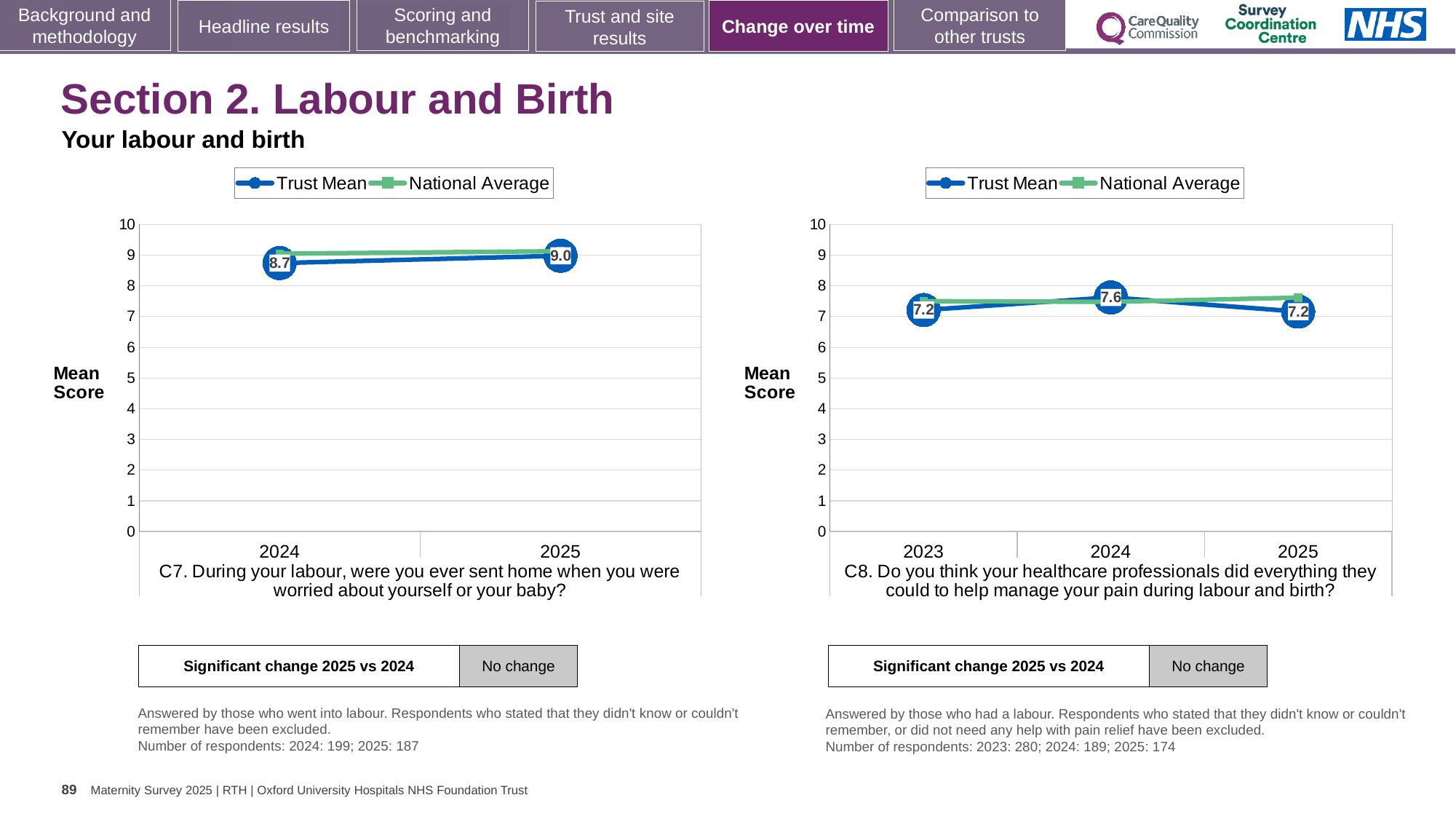
How many series does the legend of the left chart (C7) list? 2 In the right chart (C8), what is the difference between the Trust Mean in 2024 and in 2025? 0.4 In the left chart (C7), what is the Trust Mean score for 2024? 8.7 In the right chart (C8), which year has the highest Trust Mean score? 2024 In the left chart (C7), does the Trust Mean rise or fall from 2024 to 2025? rise In the left chart (C7), what is the Trust Mean score for 2025? 9.0 In the right chart (C8), what is the Trust Mean score for 2024? 7.6 What kind of chart is the right chart (C8)? line chart In the left chart (C7), by how much did the Trust Mean change from 2024 to 2025? 0.3 How many years are plotted on the x axis of the right chart (C8)? 3 In the right chart (C8), what is the Trust Mean score for 2023? 7.2 In the right chart (C8), is the National Average value for 2023 greater or less than 7? greater